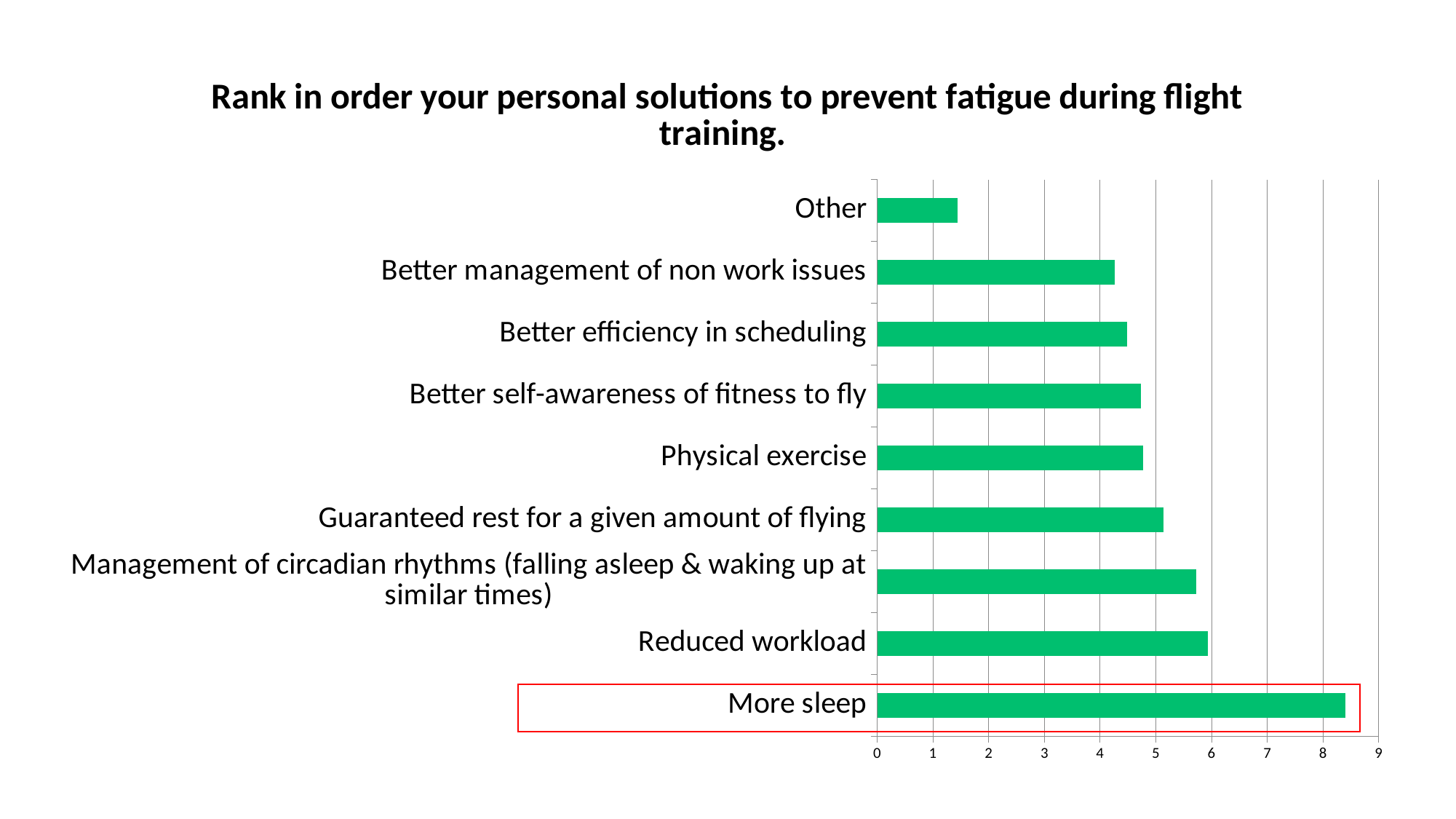
What is the title of the chart? Rank in order your personal solutions to prevent fatigue during flight training. Which category has the highest value? More sleep Is the value for Other greater or less than 2? less How many categories are plotted in the chart? 9 Which is larger, the value for Reduced workload or the value for Physical exercise? Reduced workload Which category has the lowest value? Other Which is larger, the value for Other or the value for Better efficiency in scheduling? Better efficiency in scheduling What kind of chart is shown on the slide? bar chart Is the value for Reduced workload greater or less than 5? greater Is the value for More sleep greater or less than 8? greater